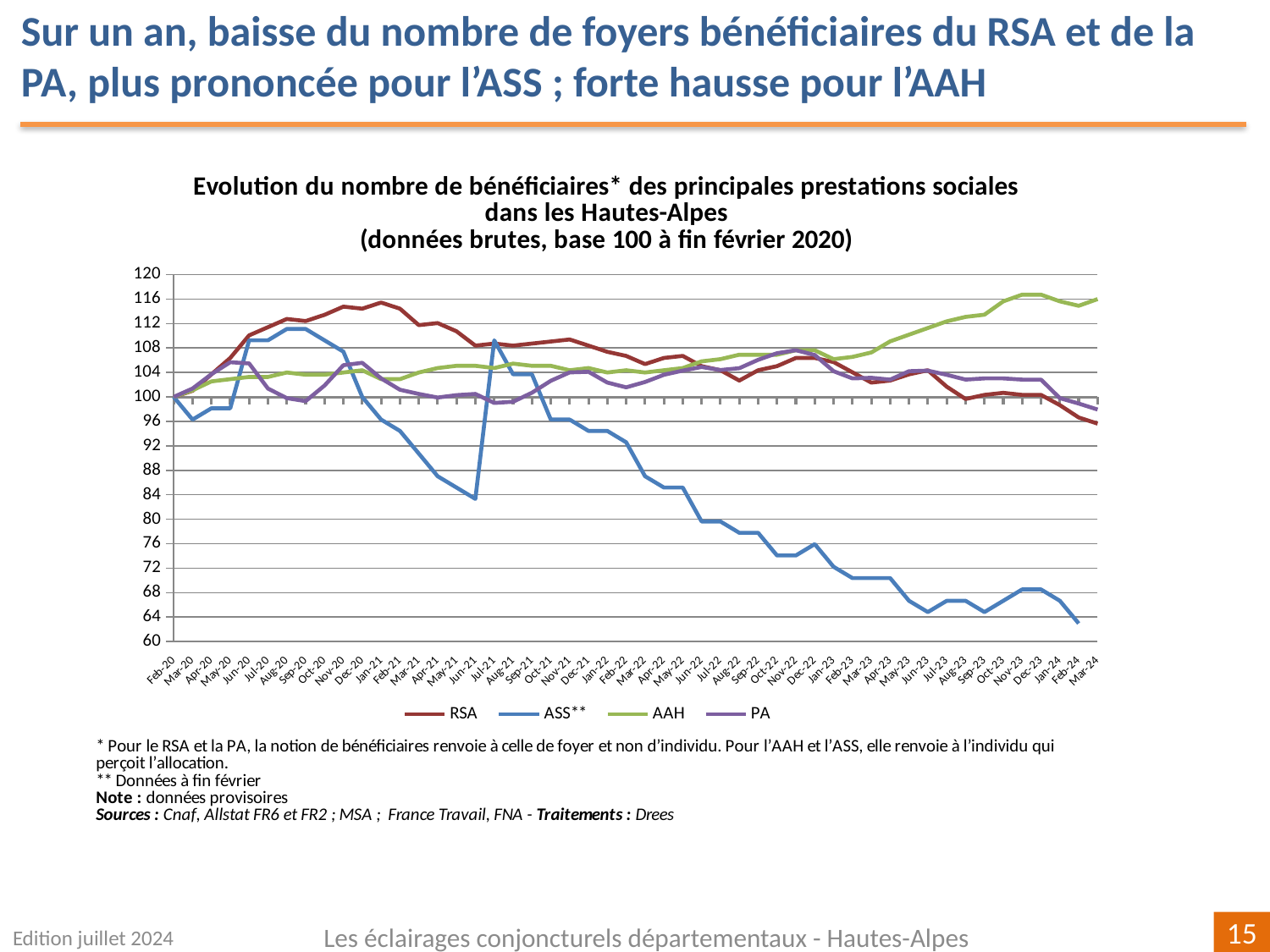
Is the value for AAH at Mar-24 greater or less than 112? greater What kind of chart is shown on the slide? line chart Is the value for RSA at Jan-21 greater or less than 112? greater What is the base value of the index at fin février 2020, according to the chart title? 100 Does the ASS** series overall rise or fall from Feb-20 to Mar-24? fall At Mar-24, which is larger: the value for RSA or the value for AAH? AAH Which series has the highest value at Mar-24? AAH How many series does the legend list? 4 Does the AAH series overall rise or fall from Feb-20 to Mar-24? rise Is the value for ASS** at Jun-21 greater or less than 88? less Which series has the lowest value at Mar-24? RSA